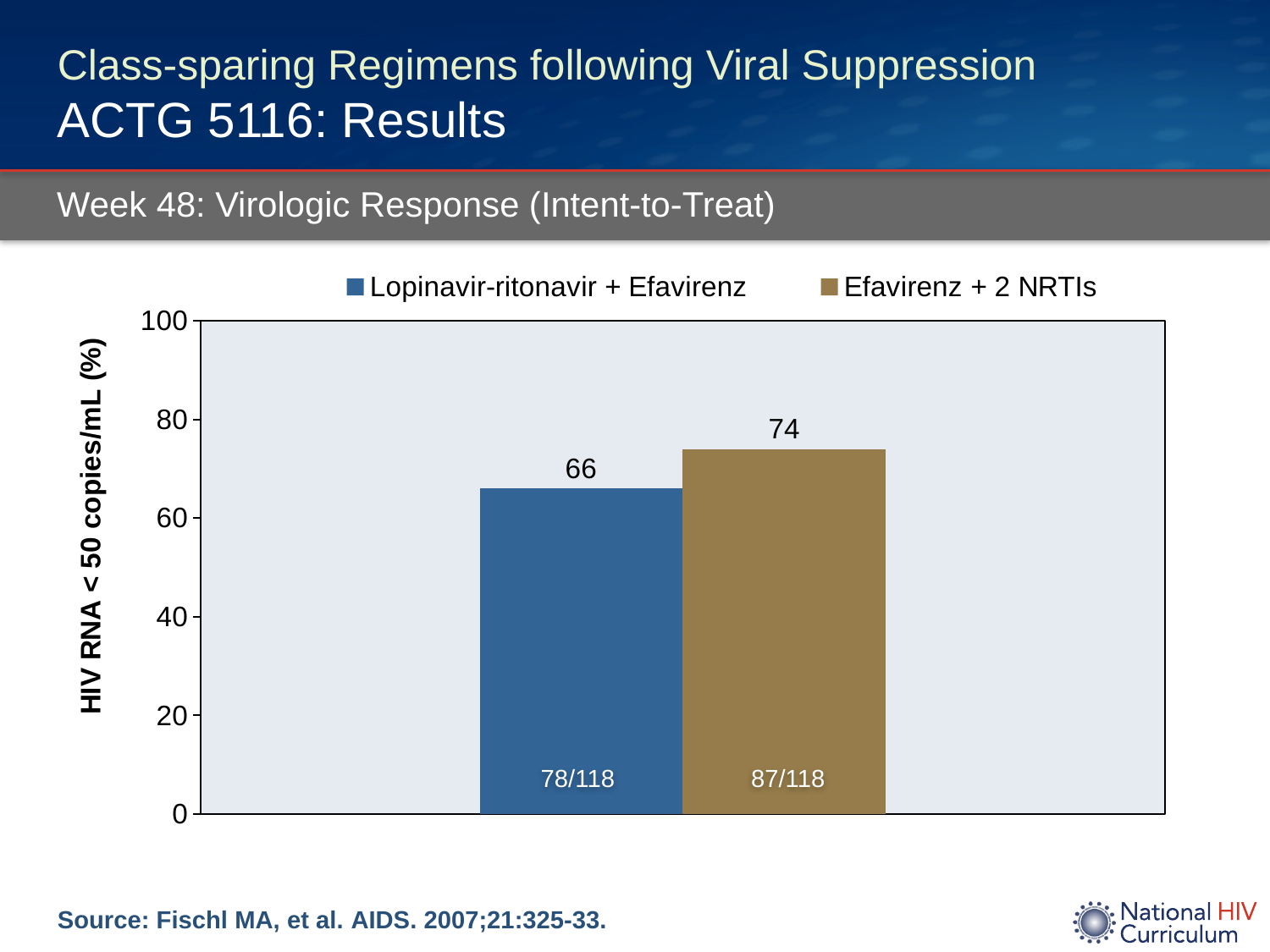
What is the value for Lopinavir-ritonavir + Efavirenz? 66 Is the value for Lopinavir-ritonavir + Efavirenz greater or less than 60? greater What fraction is printed inside the bar for Efavirenz + 2 NRTIs? 87/118 What kind of chart is shown? Bar chart What is the label of the y axis? HIV RNA < 50 copies/mL (%) Which series has the lower value? Lopinavir-ritonavir + Efavirenz What is the value for Efavirenz + 2 NRTIs? 74 Is the value for Efavirenz + 2 NRTIs greater or less than 80? less Which series has the higher value? Efavirenz + 2 NRTIs What is the difference between the values for Efavirenz + 2 NRTIs and Lopinavir-ritonavir + Efavirenz? 8 What fraction is printed inside the bar for Lopinavir-ritonavir + Efavirenz? 78/118 How many series does the legend list? 2